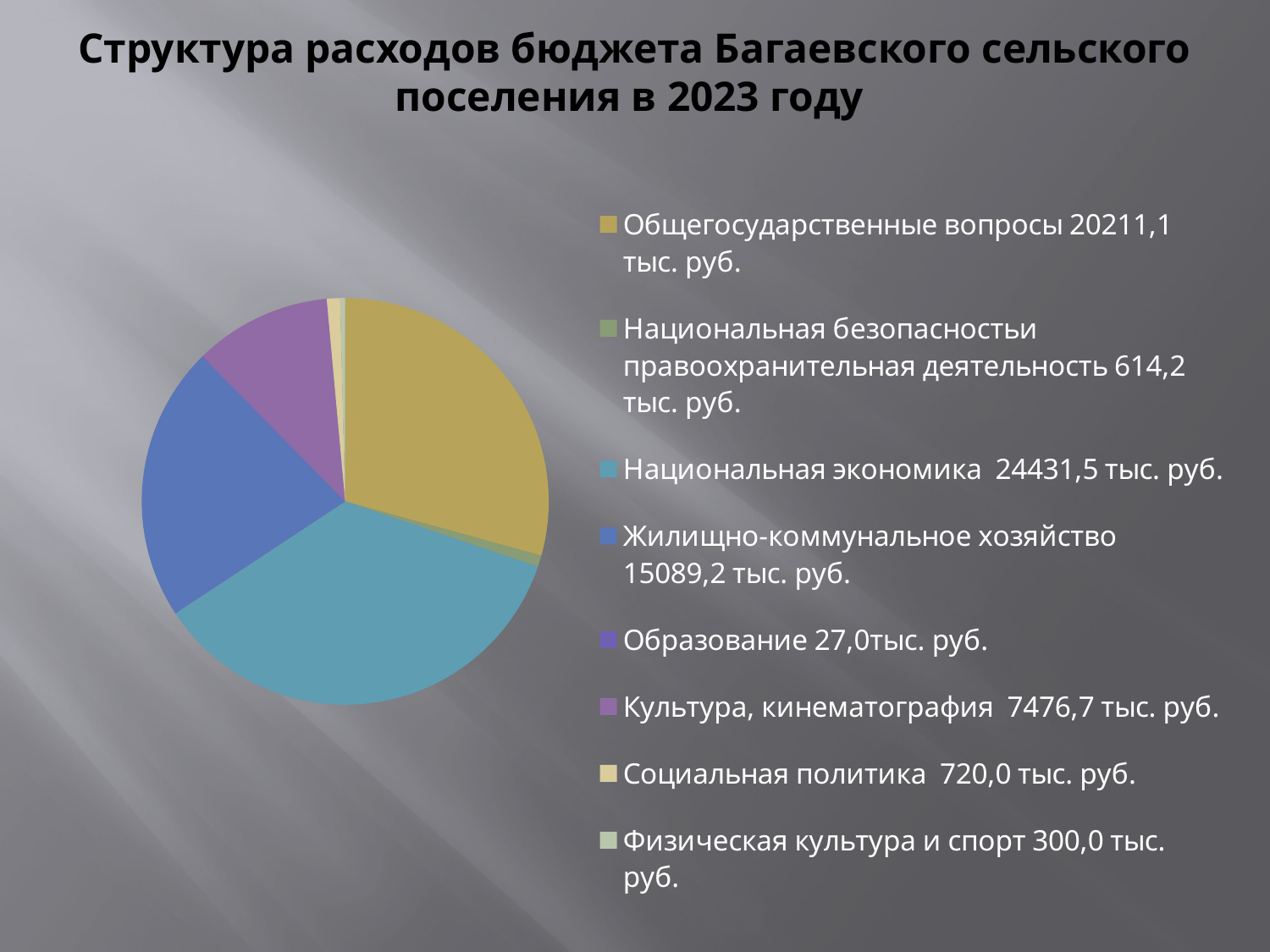
What kind of chart is shown on the slide? Pie chart Which category has the largest share of the pie? Национальная экономика What is the value for Социальная политика? 720,0 тыс. руб. What is the difference between Общегосударственные вопросы and Жилищно-коммунальное хозяйство? 5121,9 тыс. руб. Which category has the smallest value? Образование What is the title of the chart? Структура расходов бюджета Багаевского сельского поселения в 2023 году What is the value for Национальная экономика? 24431,5 тыс. руб. What is the difference between Национальная экономика and Общегосударственные вопросы? 4220,4 тыс. руб. How many categories does the pie chart have? 8 Which is larger: Жилищно-коммунальное хозяйство or Культура, кинематография? Жилищно-коммунальное хозяйство What is the value for Жилищно-коммунальное хозяйство? 15089,2 тыс. руб. What is the value for Культура, кинематография? 7476,7 тыс. руб.